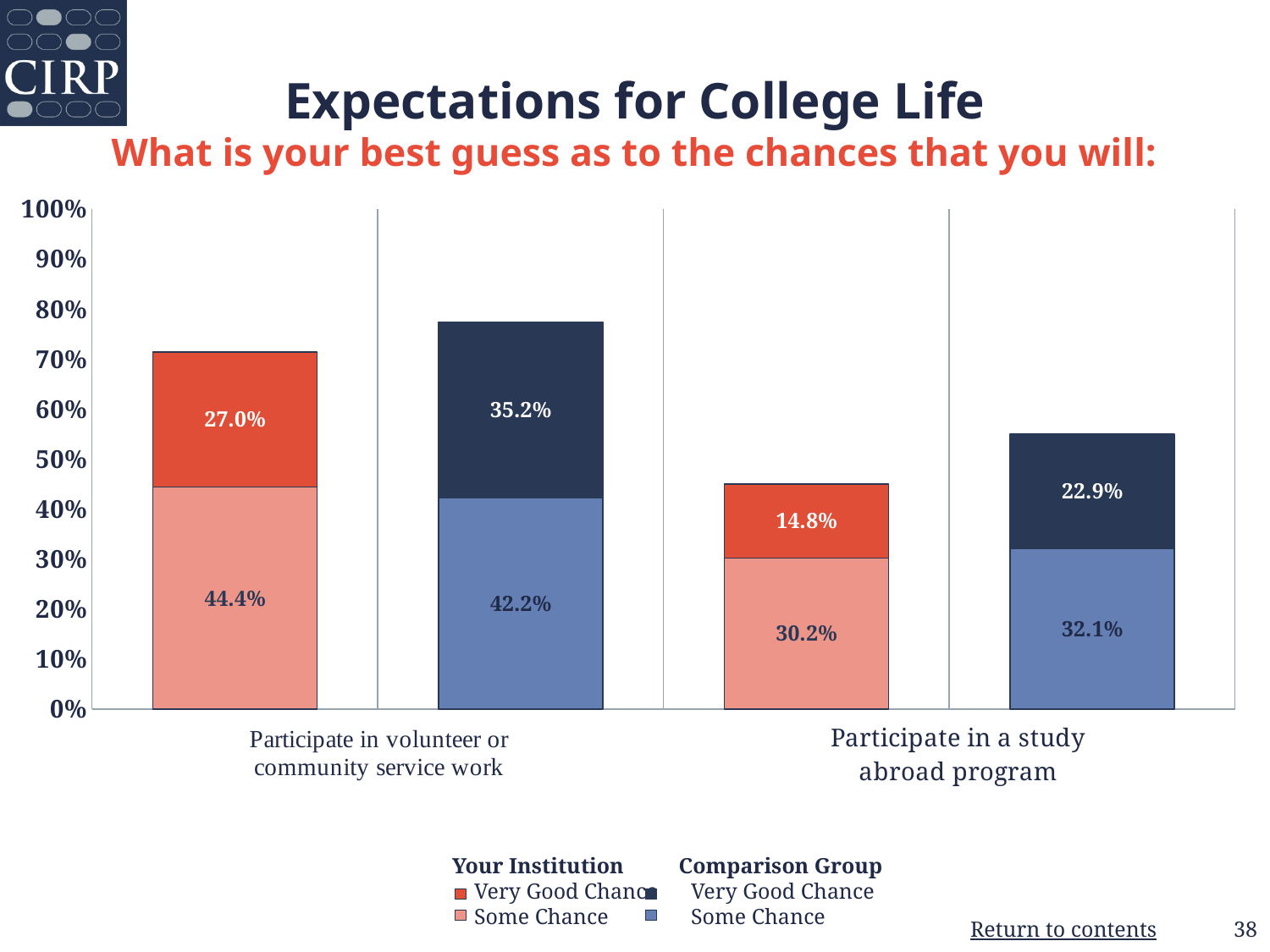
What is the total height of the Your Institution stacked bar for participating in volunteer or community service work? 71.4% What is the 'Some Chance' value for Your Institution for participating in volunteer or community service work? 44.4% How many categories are shown on the x axis of the chart? 2 Which is larger for participating in a study abroad program: the 'Some Chance' value for Your Institution or for the Comparison Group? Comparison Group How many series does the legend list? 4 What is the difference between the Comparison Group and Your Institution 'Very Good Chance' values for participating in volunteer or community service work? 8.2% What percentage of the Comparison Group said there is 'Some Chance' they will participate in a study abroad program? 32.1% What is the 'Very Good Chance' value for the Comparison Group for participating in a study abroad program? 22.9% What is the total height of the Comparison Group stacked bar for participating in a study abroad program? 55.0% What percentage of Your Institution students said there is a 'Very Good Chance' they will participate in volunteer or community service work? 27.0% What kind of chart is shown on the slide? Stacked bar chart Is the total of the Your Institution stacked bar for participating in a study abroad program greater or less than 50%? less